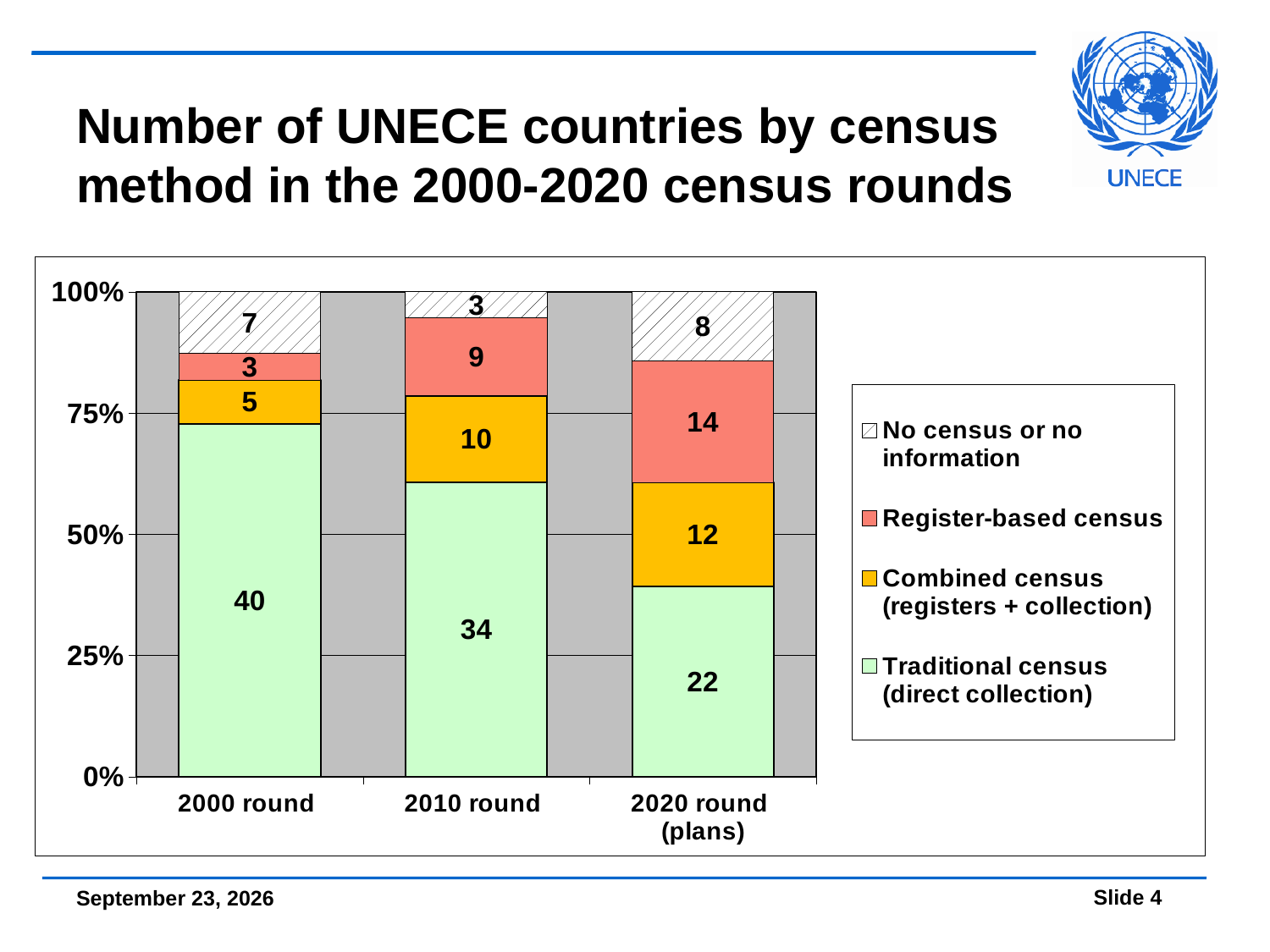
How many countries used a traditional census (direct collection) in the 2000 round? 40 How many series does the legend list? 4 How many countries are planning a register-based census in the 2020 round? 14 What is the difference between the number of countries with a traditional census in the 2000 round and in the 2020 round? 18 In which census round was the number of countries with a register-based census highest? 2020 round (plans) Which is larger in the 2010 round: the number of countries with a combined census or with a register-based census? Combined census Does the number of countries with a traditional census rise or fall from the 2000 round to the 2020 round? Fall How many census rounds are shown on the x axis? 3 How many countries used a combined census (registers + collection) in the 2010 round? 10 In which census round was the number of countries with a traditional census (direct collection) lowest? 2020 round (plans) What is the total number of countries in the 2020 round (plans) bar? 56 What kind of chart is shown on the slide? Stacked bar chart